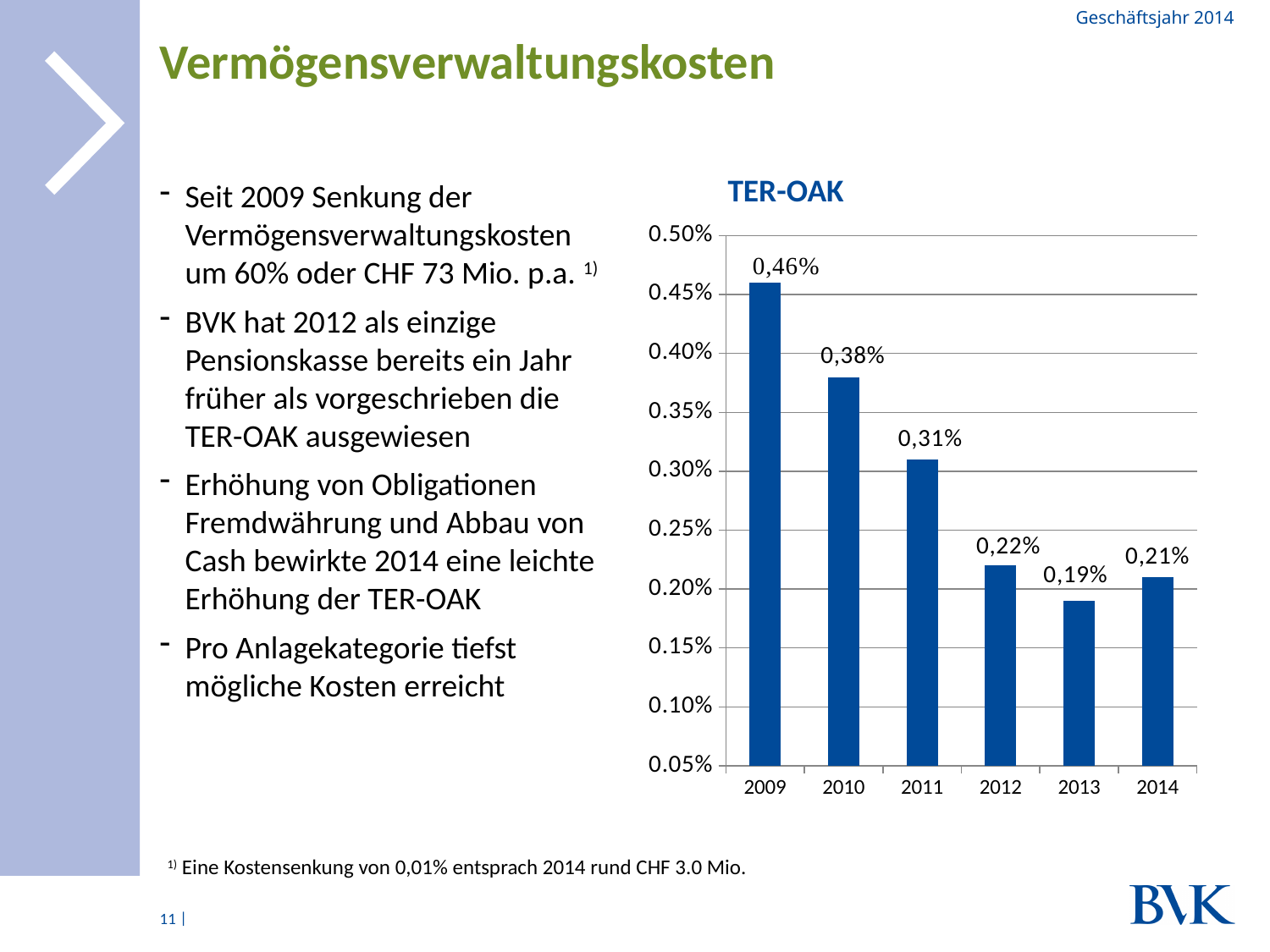
What is the TER-OAK value for 2009? 0,46% What kind of chart is the TER-OAK chart? bar chart What is the difference between the TER-OAK values for 2009 and 2014? 0,25% What is the TER-OAK value for 2014? 0,21% Do the TER-OAK values generally rise or fall from 2009 to 2013? fall Which year has the highest TER-OAK value? 2009 Which year has the lowest TER-OAK value? 2013 What is the TER-OAK value for 2013? 0,19% What is the difference between the TER-OAK values for 2010 and 2011? 0,07% How many years are shown on the x axis of the TER-OAK chart? 6 Is the TER-OAK value for 2011 greater or less than 0.30%? greater Which is larger, the TER-OAK value for 2012 or for 2014? 2012